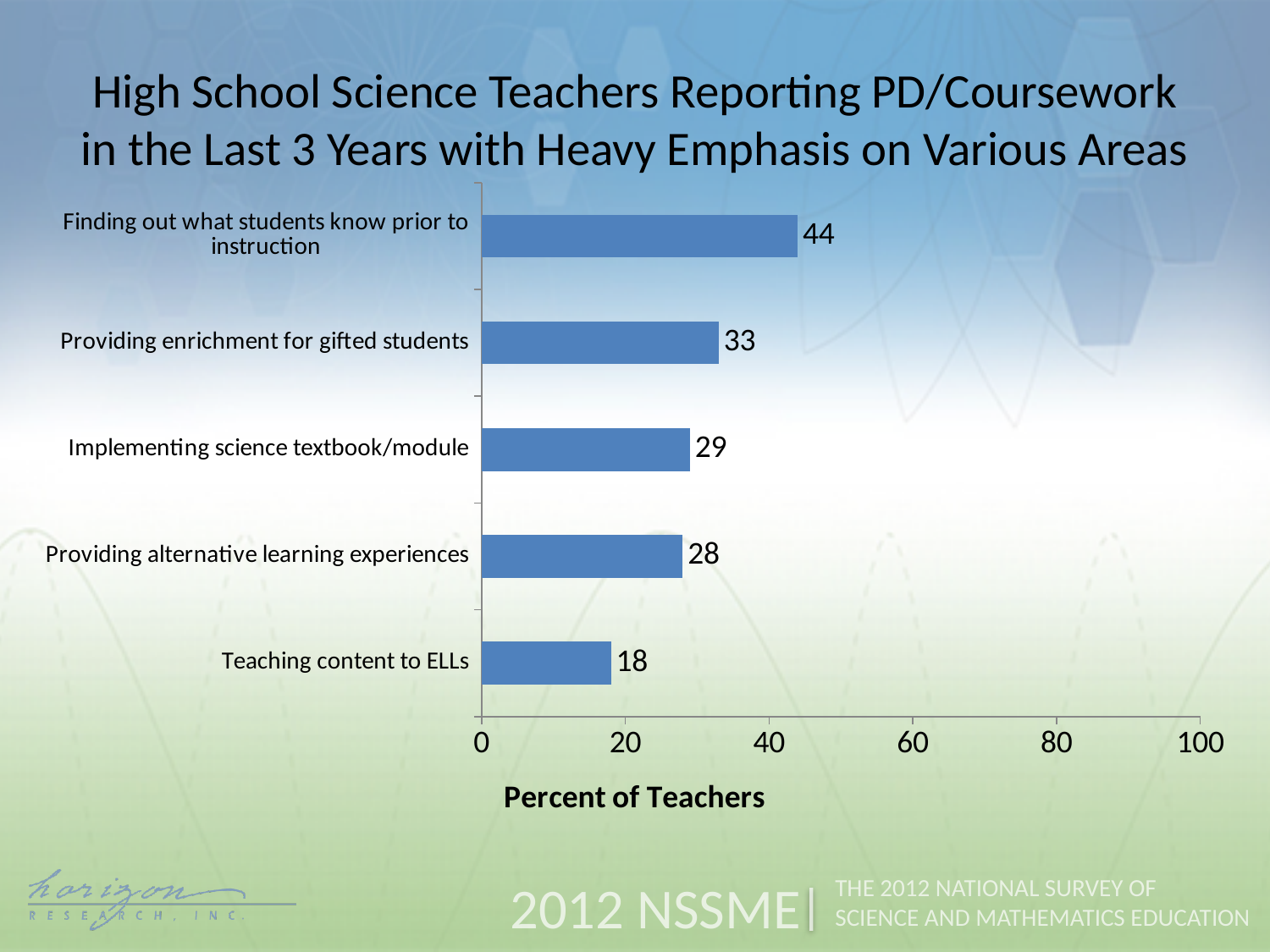
What is the value for Teaching content to ELLs? 18 What percent of teachers reported PD/coursework with heavy emphasis on finding out what students know prior to instruction? 44 What is the difference between the values for Implementing science textbook/module and Providing alternative learning experiences? 1 Which area has the highest percent of teachers? Finding out what students know prior to instruction What kind of chart is shown on the slide? Bar chart Which is larger: the value for Providing enrichment for gifted students or the value for Implementing science textbook/module? Providing enrichment for gifted students Is the value for Finding out what students know prior to instruction greater or less than 40? greater Which area has the lowest percent of teachers? Teaching content to ELLs What is the difference between the highest and lowest values on the chart? 26 What is the value for Providing enrichment for gifted students? 33 How many areas are shown on the chart? 5 What is the label of the horizontal axis? Percent of Teachers